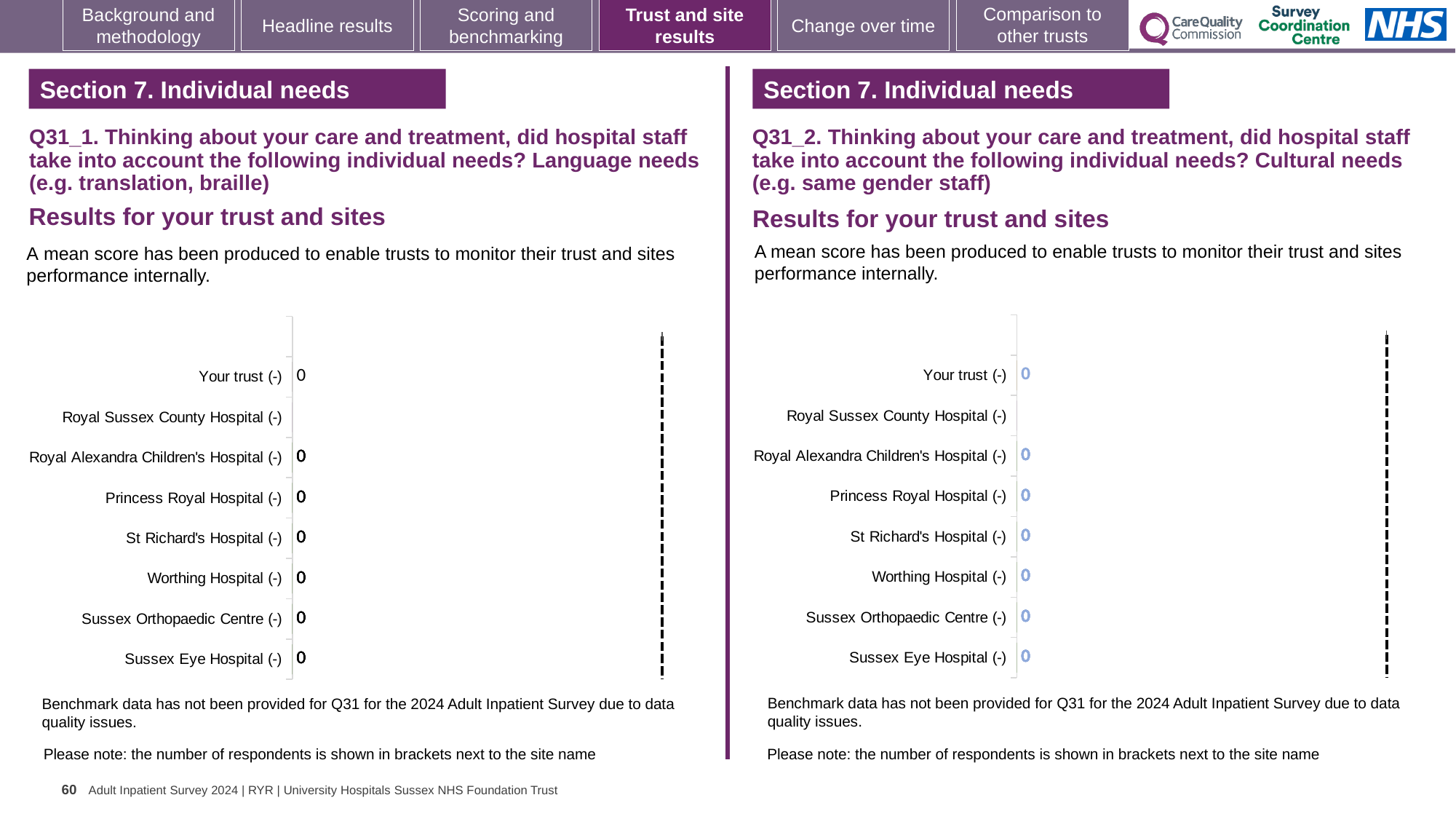
In the left chart (Q31_1, Language needs), what is the difference between the values for Your trust (-) and Sussex Eye Hospital (-)? 0 In the right chart (Q31_2, Cultural needs), what is the value shown for Princess Royal Hospital (-)? 0 How many categories are listed on the right chart (Q31_2, Cultural needs)? 8 In the left chart (Q31_1, Language needs), what is the value shown for Worthing Hospital (-)? 0 Which section heading appears above both charts on the slide? Section 7. Individual needs In the right chart (Q31_2, Cultural needs), which category has no value label shown next to it? Royal Sussex County Hospital (-) In the right chart (Q31_2, Cultural needs), what is the value shown for Sussex Orthopaedic Centre (-)? 0 How many categories are listed on the left chart (Q31_1, Language needs)? 8 In the left chart (Q31_1, Language needs), what is the value shown for Sussex Eye Hospital (-)? 0 In the right chart (Q31_2, Cultural needs), what is the value shown for St Richard's Hospital (-)? 0 In the left chart (Q31_1, Language needs), what is the value shown for Your trust (-)? 0 What kind of chart is the left chart (Q31_1, Language needs)? Bar chart